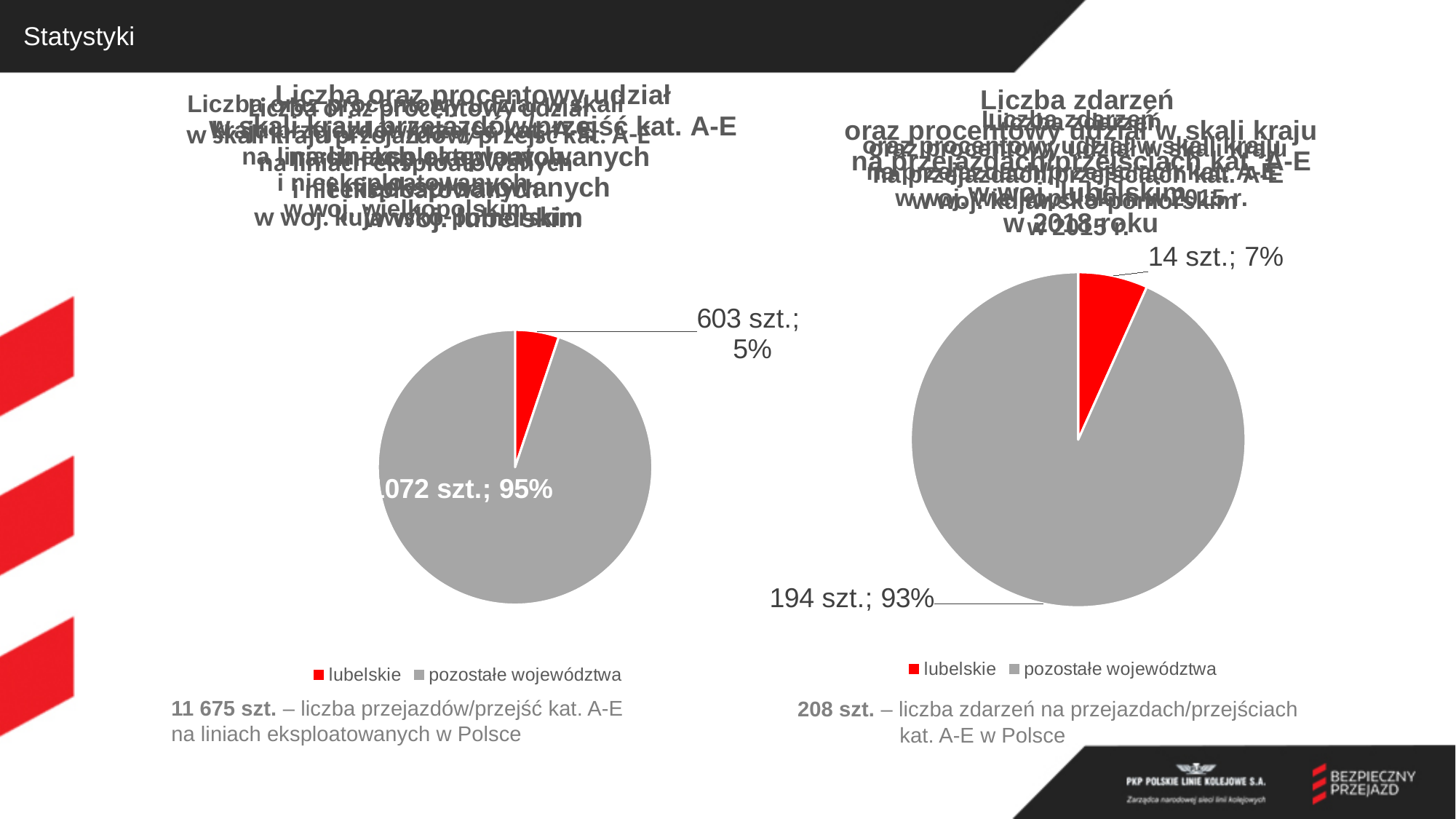
How many entries does the legend of the left pie chart list? 2 What kind of chart is the chart on the left side of the slide? pie chart In the right pie chart, which slice is the smallest? lubelskie In the left pie chart, which slice is larger: lubelskie or pozostałe województwa? pozostałe województwa In the right pie chart, what percentage share does the lubelskie slice have? 7% In the right pie chart, how many szt. are shown for lubelskie? 14 szt. In the right pie chart, what colour is the lubelskie slice? red In the right pie chart, how many szt. are shown for pozostałe województwa? 194 szt. In the right pie chart, what is the difference in szt. between pozostałe województwa and lubelskie? 180 szt. In the left pie chart, how many szt. are shown for lubelskie? 603 szt. In the left pie chart, what percentage share does the lubelskie slice have? 5% In the right pie chart, what is the total number of szt. across both slices? 208 szt.